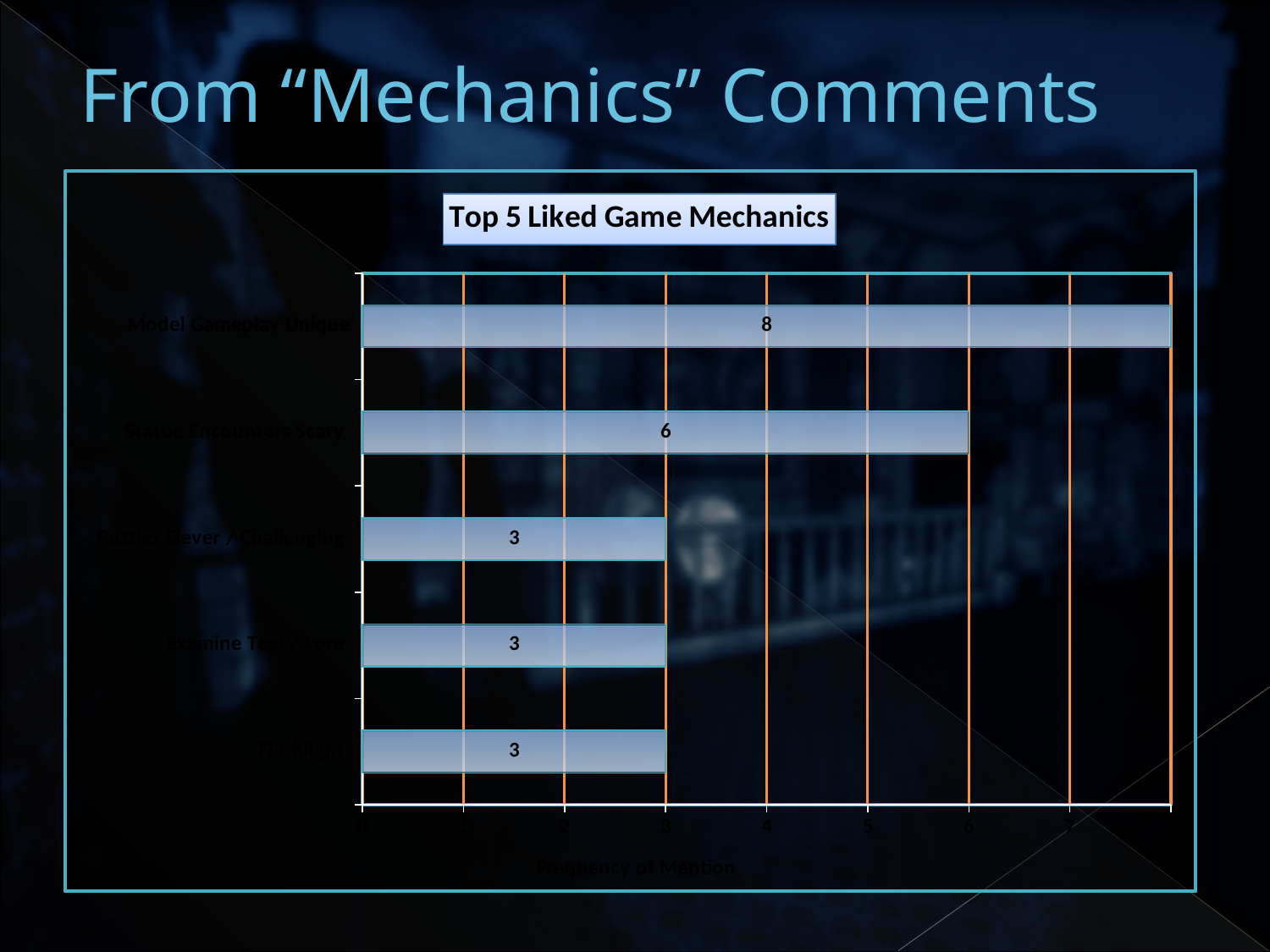
What kind of chart is shown on the slide? bar chart What is the value for Examine Text / Lore? 3 How many categories are shown in the chart? 5 Which category has the highest frequency of mention? Model Gameplay Unique Is the value for Model Gameplay Unique greater or less than 5? greater What is the value for Flashlight? 3 What is the value for Statue Encounters Scary? 6 What is the difference between the values for Model Gameplay Unique and Statue Encounters Scary? 2 What is the value for Model Gameplay Unique? 8 What is the title of the chart? Top 5 Liked Game Mechanics What is the difference between the values for Statue Encounters Scary and Puzzles Clever / Challenging? 3 Which is larger, the value for Statue Encounters Scary or the value for Flashlight? Statue Encounters Scary